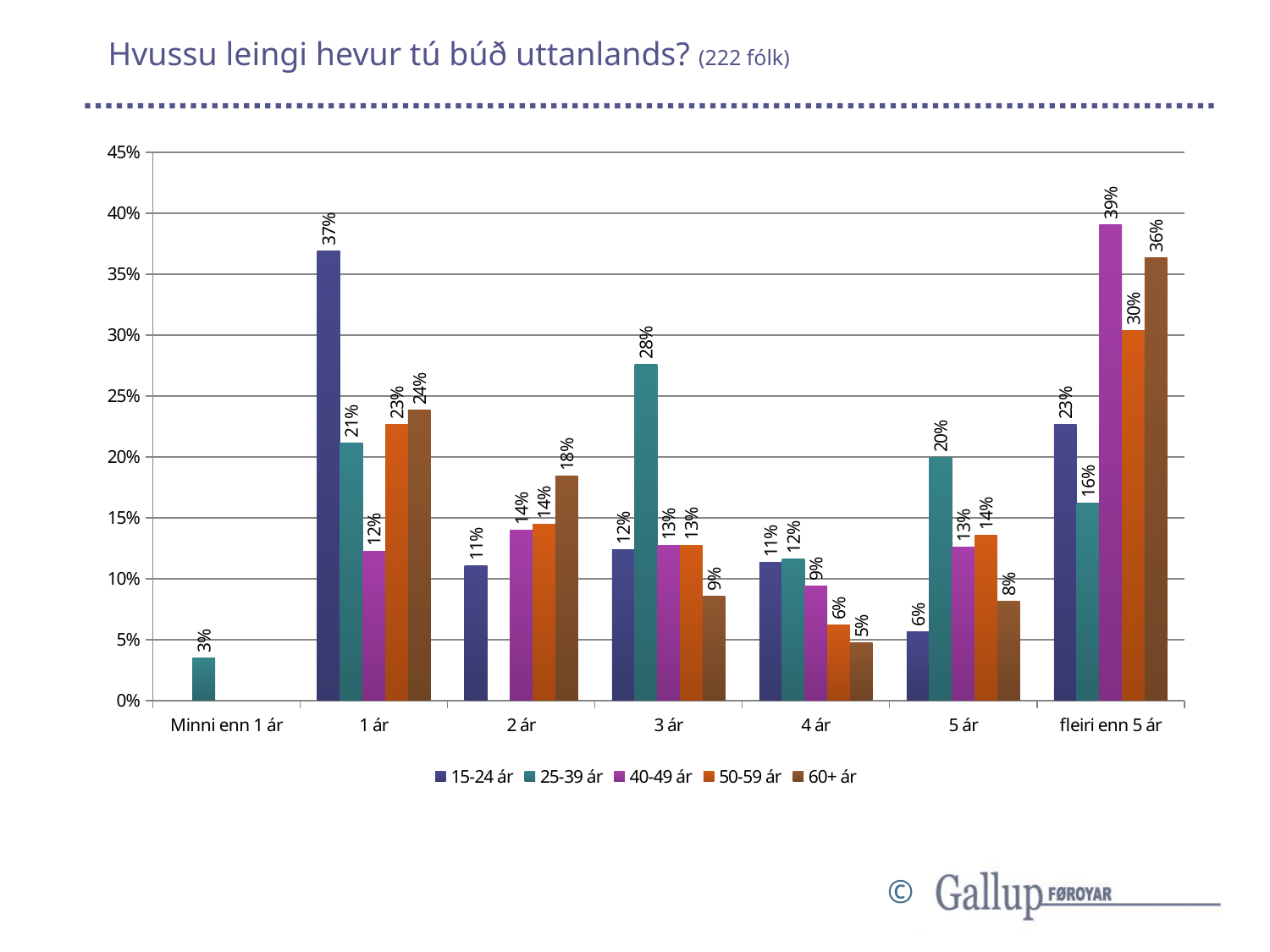
In which category does the 15-24 ár series have its lowest value? 5 ár What is the value for the 25-39 ár series in the Minni enn 1 ár category? 3% How many people does the chart title say were surveyed? 222 fólk In the fleiri enn 5 ár category, what is the difference between the 40-49 ár value and the 25-39 ár value? 23 percentage points What is the value for the 25-39 ár series in the 3 ár category? 28% How many categories are shown on the x axis? 7 What is the value for the 15-24 ár series in the 1 ár category? 37% What kind of chart is shown on the slide? Bar chart In the 5 ár category, which is larger: the 25-39 ár value or the 50-59 ár value? 25-39 ár In which category does the 60+ ár series reach its highest value? fleiri enn 5 ár How many series does the legend list? 5 What is the value for the 40-49 ár series in the fleiri enn 5 ár category? 39%